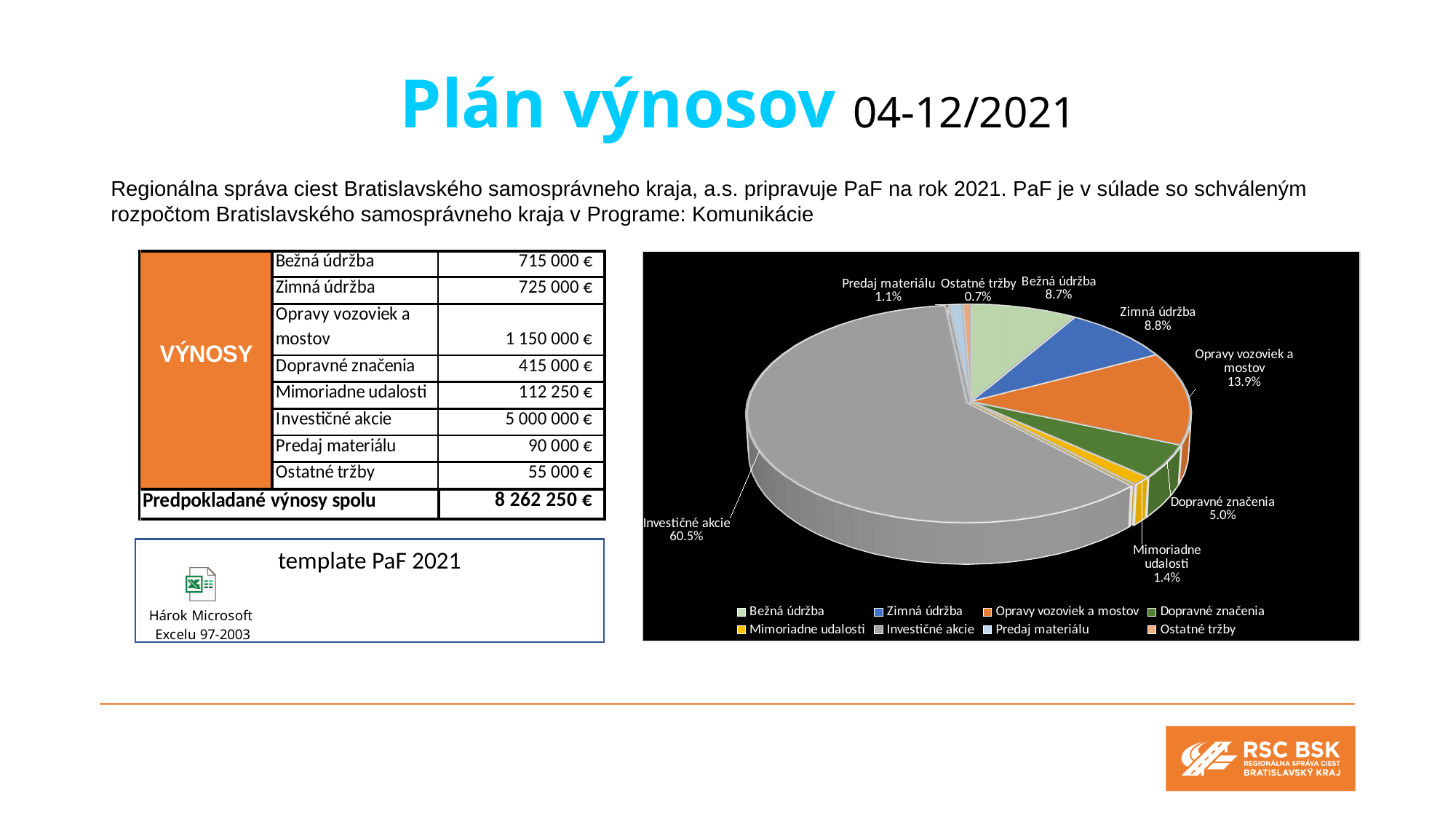
How many slices does the pie chart have? 8 How many entries does the pie chart's legend list? 8 What kind of chart is shown on the slide? pie chart What percentage is shown for Mimoriadne udalosti in the pie chart? 1.4% Which slice of the pie chart is the smallest? Ostatné tržby What share of the pie does Opravy vozoviek a mostov represent? 13.9% What is the difference in percentage points between Opravy vozoviek a mostov and Dopravné značenia in the pie chart? 8.9 What percentage is shown for Ostatné tržby in the pie chart? 0.7% Which slice is larger in the pie chart, Opravy vozoviek a mostov or Dopravné značenia? Opravy vozoviek a mostov Which slice of the pie chart is the largest? Investičné akcie What share of the pie does Investičné akcie represent? 60.5% What percentage is shown for Dopravné značenia in the pie chart? 5.0%